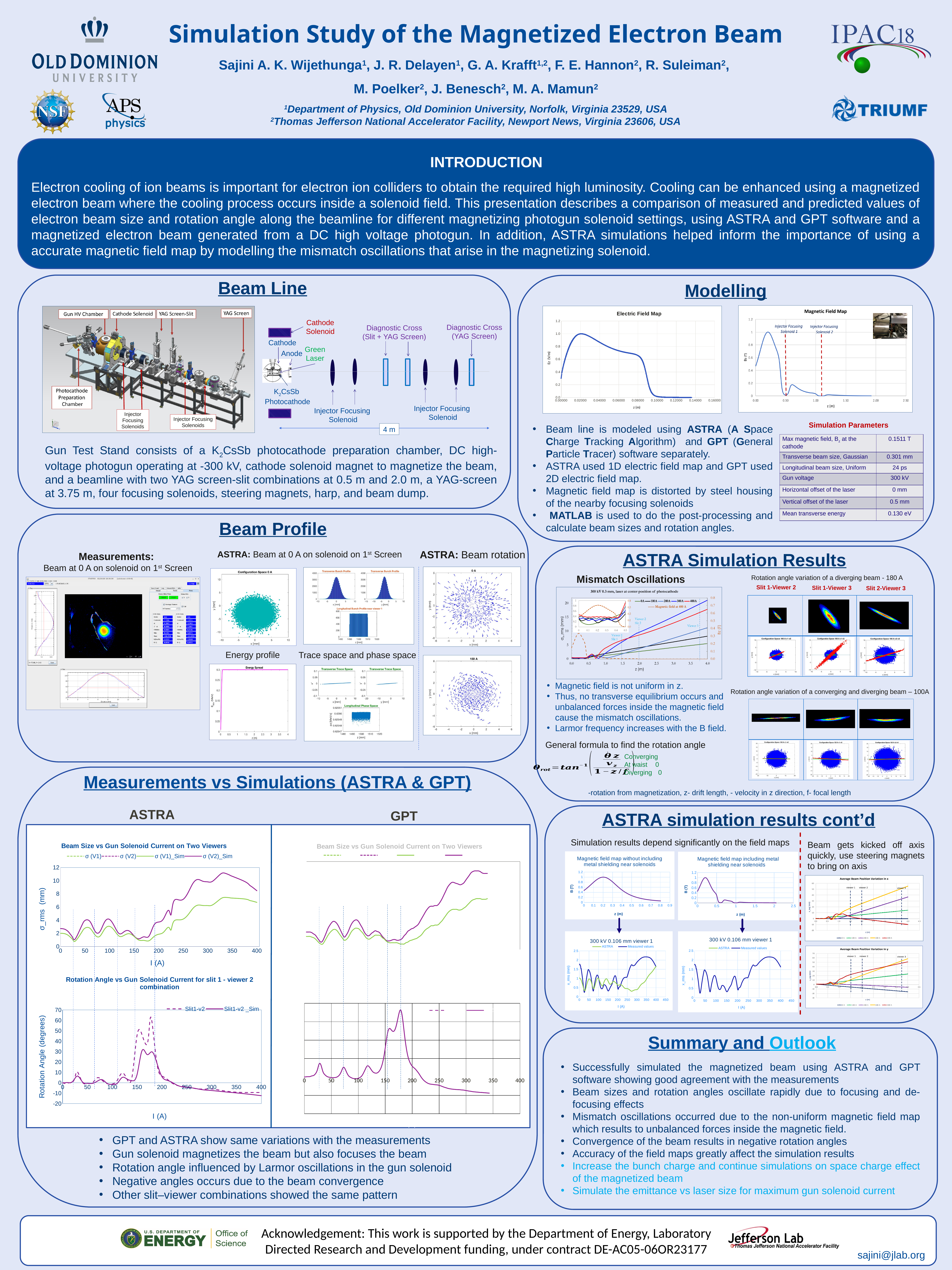
In the ASTRA chart 'Beam Size vs Gun Solenoid Current on Two Viewers', is the value of σ (V2)_Sim at 300 A greater or less than 6? greater In the chart 'Rotation Angle vs Gun Solenoid Current for slit 1 - viewer 2 combination', what is the highest tick value shown on the y axis? 70 In the '300 kV 0.106 mm viewer 1' charts in the 'ASTRA simulation results cont'd' section, how many series does the legend list? 2 In the ASTRA chart 'Beam Size vs Gun Solenoid Current on Two Viewers', is the value of σ (V1)_Sim at 400 A greater or less than 10? less In the chart 'Rotation Angle vs Gun Solenoid Current for slit 1 - viewer 2 combination', is the rotation angle at 300 A greater or less than 20 degrees? less In the ASTRA chart 'Beam Size vs Gun Solenoid Current on Two Viewers', how many series does the legend list? 4 In the ASTRA chart 'Beam Size vs Gun Solenoid Current on Two Viewers', does the σ (V2)_Sim curve generally rise or fall between 200 A and 300 A? rise In the chart 'Rotation Angle vs Gun Solenoid Current for slit 1 - viewer 2 combination', how many series does the legend list? 2 In the ASTRA chart 'Beam Size vs Gun Solenoid Current on Two Viewers', which series is higher at 350 A, σ (V1)_Sim or σ (V2)_Sim? σ (V2)_Sim In the ASTRA chart 'Beam Size vs Gun Solenoid Current on Two Viewers', what is the label of the y axis? σ_rms (mm) In the ASTRA chart 'Beam Size vs Gun Solenoid Current on Two Viewers', what kind of chart is shown? Line chart